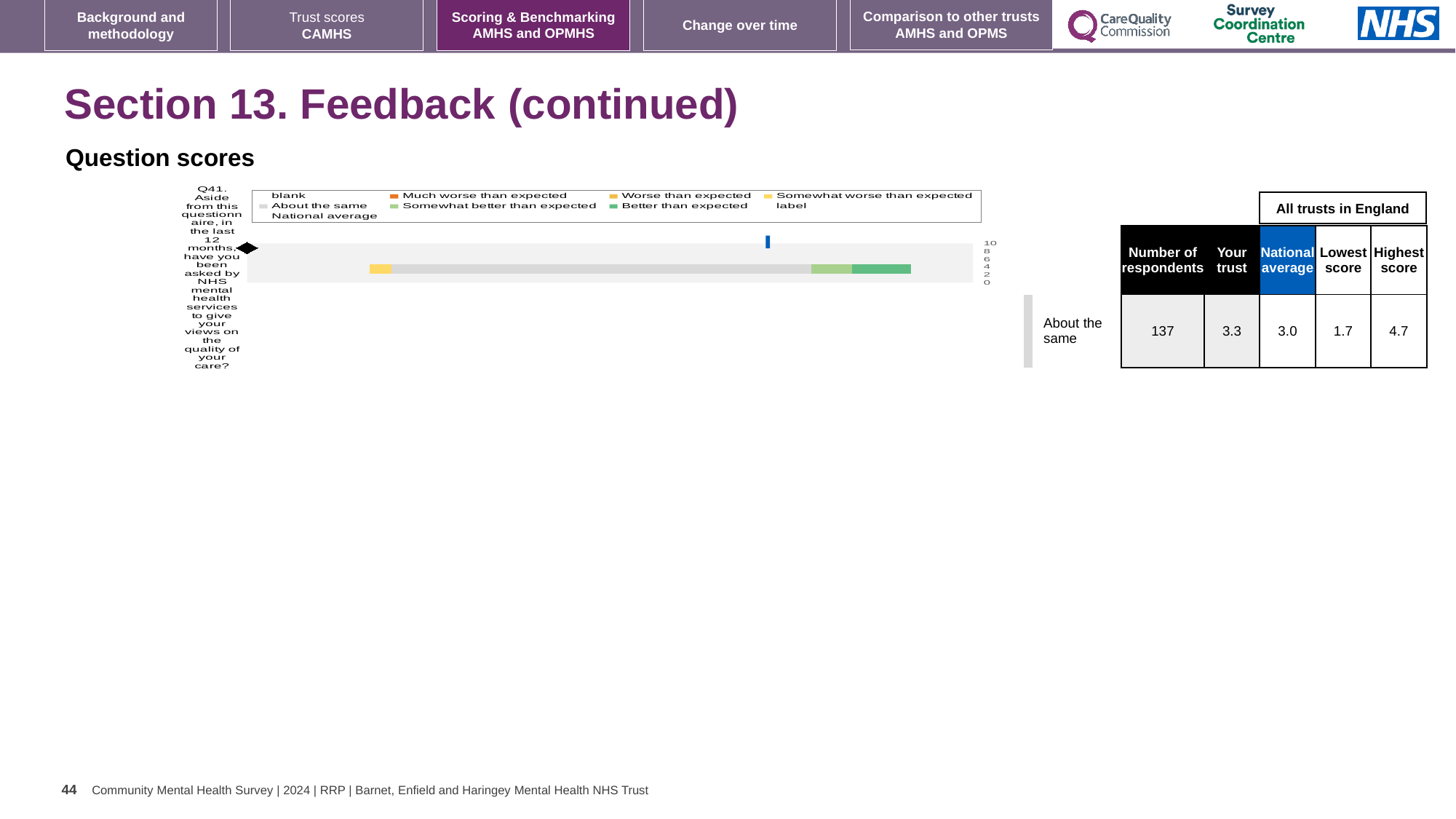
In the table beside the chart, what is the number of respondents for Q41? 137 How many entries does the chart legend list? 9 How many questions (categories) are plotted in the chart? 1 What benchmark category is the trust's Q41 score assigned to, as labelled next to the chart? About the same In the table beside the chart, what is the national average for Q41? 3.0 What is the highest value shown on the chart's axis? 10 Which legend entry is shown in orange-red in the chart? Much worse than expected In the table beside the chart, what is the 'Your trust' score for Q41? 3.3 What kind of chart is shown for Q41 on the slide? bar chart In the table beside the chart, what is the difference between the highest score and the lowest score for Q41? 3.0 Which legend entry is shown in grey in the chart? About the same In the table beside the chart, which is larger for Q41: the 'Your trust' score or the national average? Your trust